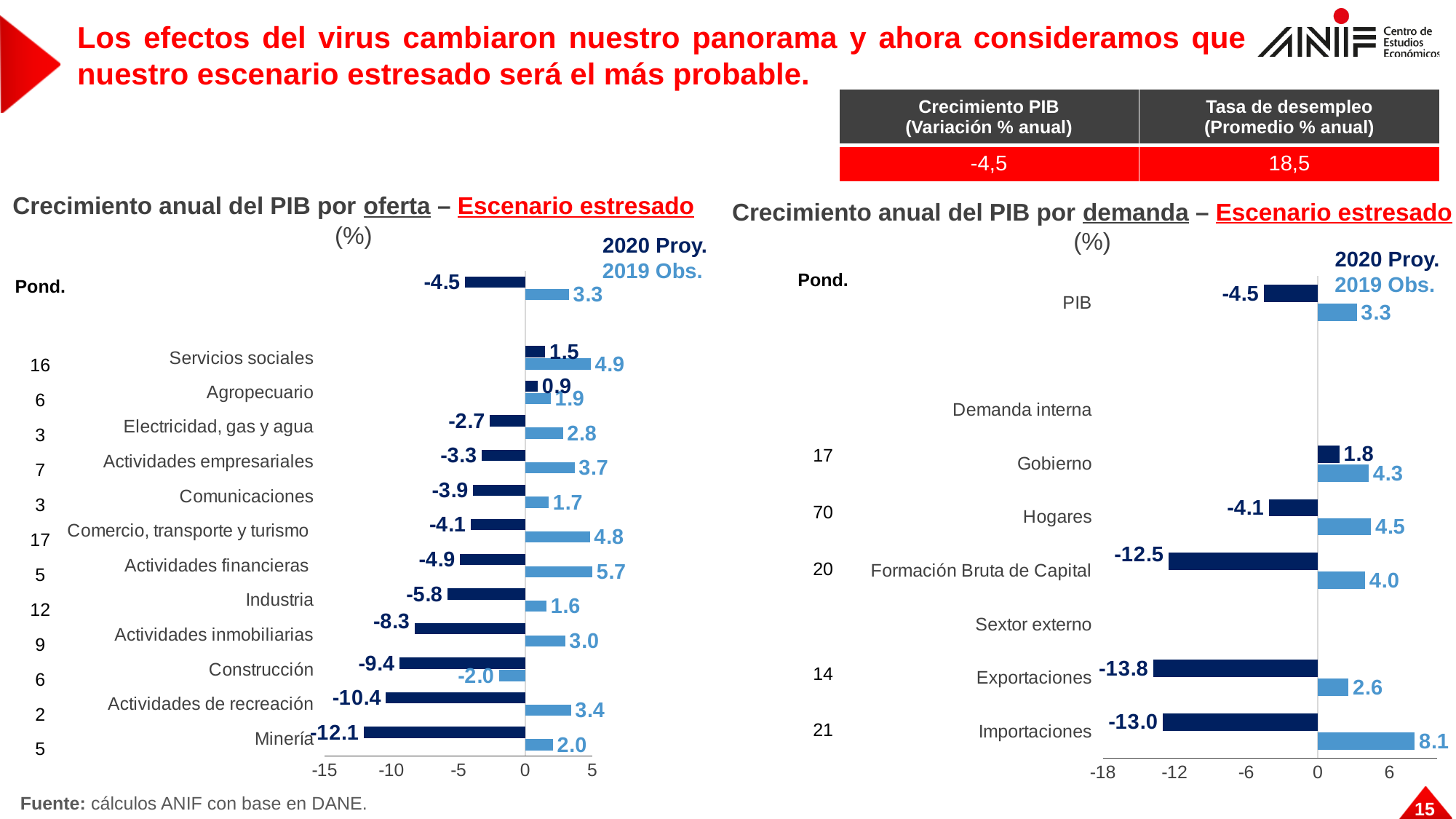
In the 'Crecimiento anual del PIB por oferta' chart, which is larger: the 2020 Proy. value for Servicios sociales or for Agropecuario? Servicios sociales In the 'Crecimiento anual del PIB por demanda' chart, what is the 2019 Obs. value for Importaciones? 8.1 In the 'Crecimiento anual del PIB por oferta' chart, which category has the lowest 2020 Proy. value? Minería In the 'Crecimiento anual del PIB por oferta' chart, what is the difference between the 2019 Obs. and 2020 Proy. values for Construcción? 7.4 In the 'Crecimiento anual del PIB por oferta' chart, what is the 2019 Obs. value for Actividades financieras? 5.7 How many series does the legend of the 'Crecimiento anual del PIB por demanda' chart list? 2 In the 'Crecimiento anual del PIB por demanda' chart, which category has the lowest 2020 Proy. value? Exportaciones What kind of chart is the 'Crecimiento anual del PIB por oferta' chart? Bar chart In the 'Crecimiento anual del PIB por oferta' chart, what is the 2020 Proy. value for Minería? -12.1 In the 'Crecimiento anual del PIB por demanda' chart, what is the difference between the 2019 Obs. and 2020 Proy. values for Formación Bruta de Capital? 16.5 In the 'Crecimiento anual del PIB por demanda' chart, what is the 2020 Proy. value for Exportaciones? -13.8 In the 'Crecimiento anual del PIB por oferta' chart, which category has the highest 2019 Obs. value? Actividades financieras